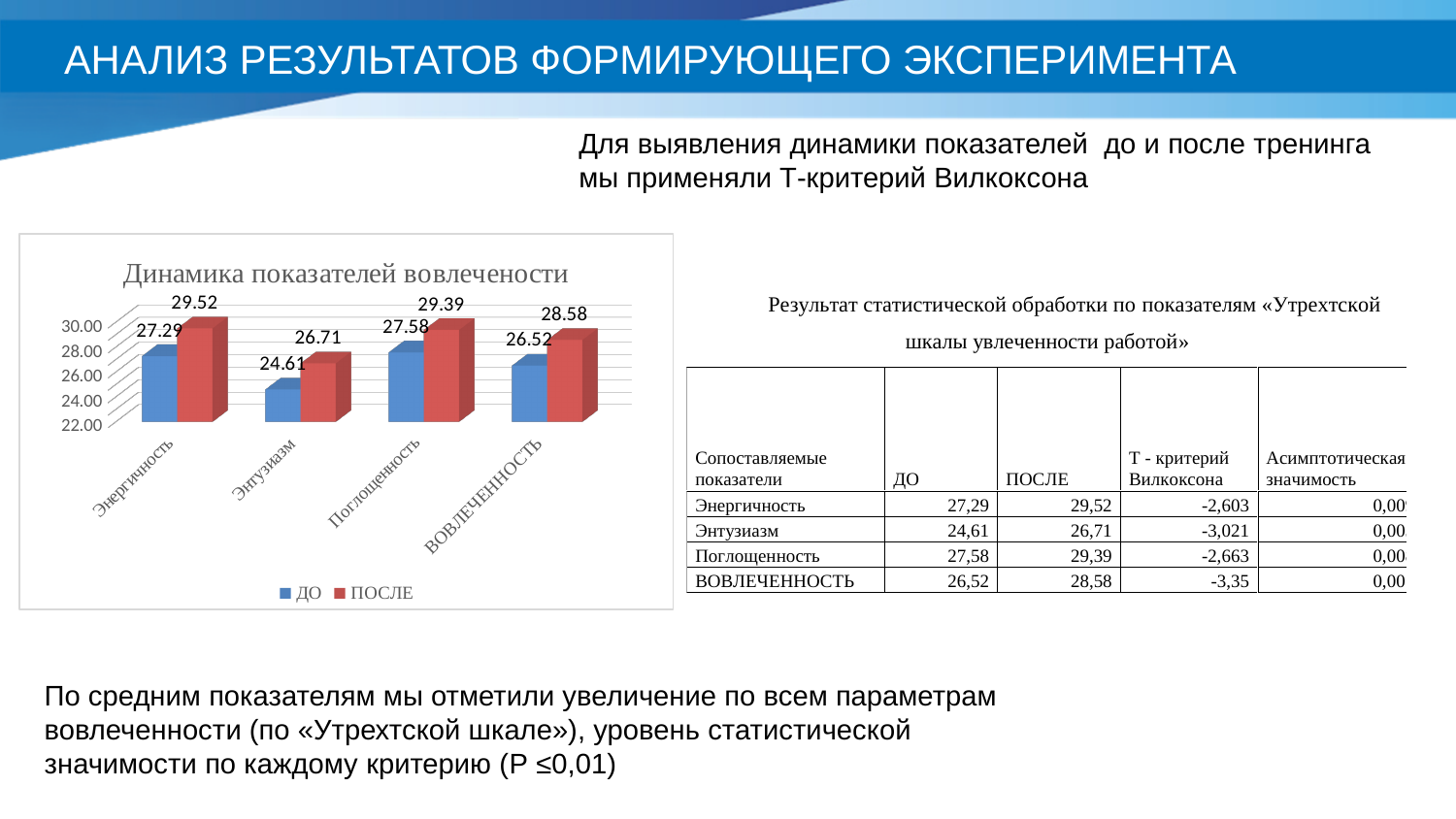
What is the difference between the ПОСЛЕ and ДО values for Энергичность? 2.23 How many series does the chart legend list? 2 What is the ПОСЛЕ value for Поглощенность in the chart? 29.39 What is the ДО value for Энергичность in the chart "Динамика показателей вовлечености"? 27.29 How many categories are shown on the x axis of the chart? 4 Which category has the highest ПОСЛЕ value in the chart? Энергичность Which category has the lowest ДО value in the chart? Энтузиазм What is the ПОСЛЕ value for Энтузиазм in the chart? 26.71 What is the ДО value for ВОВЛЕЧЕННОСТЬ in the chart? 26.52 Which is larger for Поглощенность: the ДО value or the ПОСЛЕ value? ПОСЛЕ What type of chart is shown on the slide? Bar chart What is the difference between the ПОСЛЕ and ДО values for ВОВЛЕЧЕННОСТЬ? 2.06